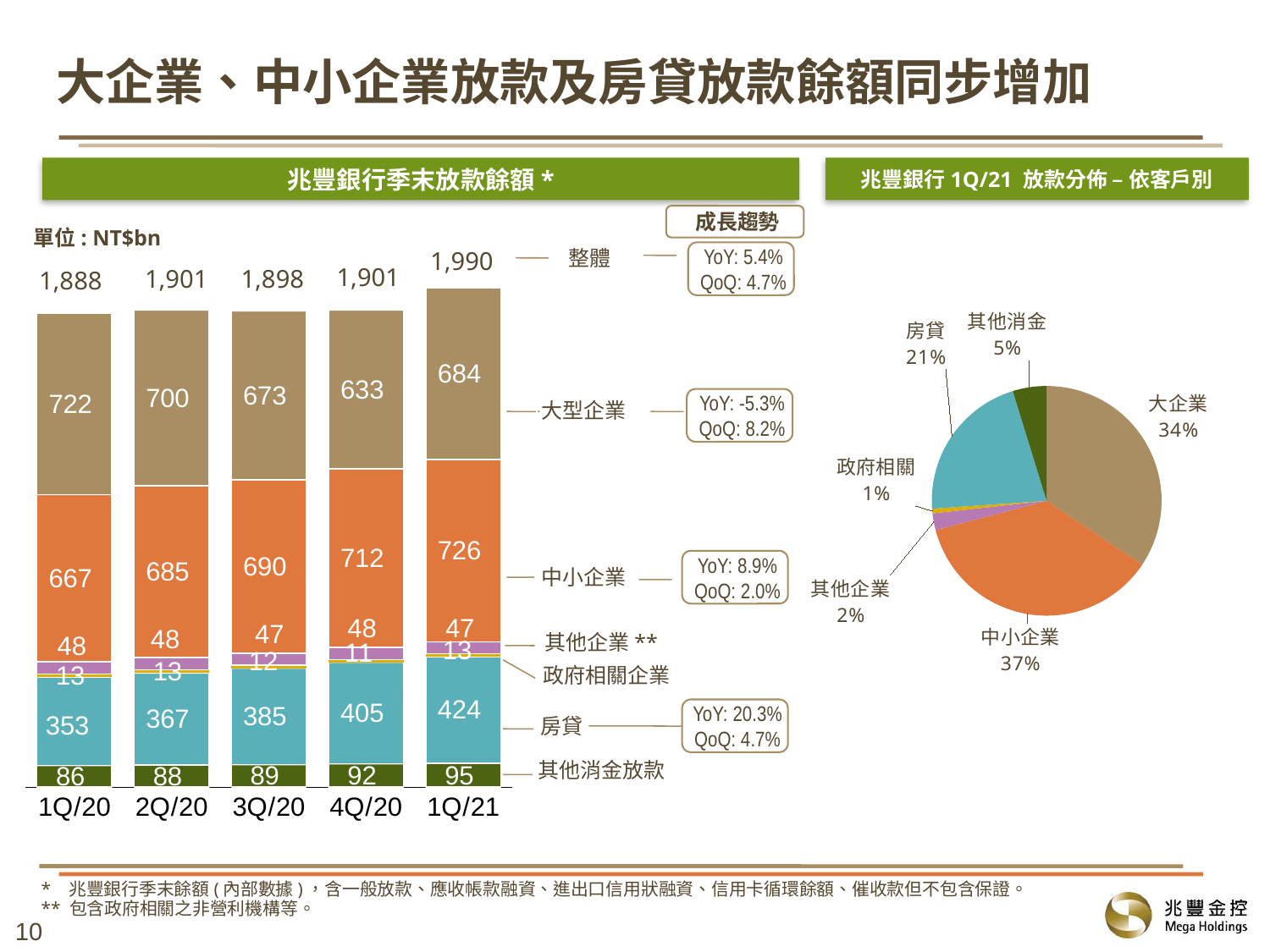
In the 兆豐銀行季末放款餘額 bar chart, by how much did the 中小企業 value increase from 1Q/20 to 1Q/21? 59 How many quarters are shown in the 兆豐銀行季末放款餘額 bar chart? 5 In the 兆豐銀行季末放款餘額 bar chart, which quarter has the lowest 大型企業 value? 4Q/20 In the 兆豐銀行 1Q/21 放款分佈 pie chart, what share does 中小企業 have? 37% In the 兆豐銀行季末放款餘額 bar chart, does the 房貸 value rise or fall from 1Q/20 to 1Q/21? Rise In the 兆豐銀行季末放款餘額 bar chart, what is the total loan balance for 1Q/21? 1,990 In the 兆豐銀行季末放款餘額 bar chart, what is the 大型企業 value for 4Q/20? 633 In the 兆豐銀行季末放款餘額 bar chart, what is the 房貸 value for 1Q/21? 424 What kind of chart is the 兆豐銀行季末放款餘額 chart on the left? Stacked bar chart In the 兆豐銀行季末放款餘額 bar chart, which is larger in 1Q/21: 大型企業 or 中小企業? 中小企業 In the 兆豐銀行季末放款餘額 bar chart, which quarter has the highest total loan balance? 1Q/21 In the 兆豐銀行 1Q/21 放款分佈 pie chart, which category has the smallest share? 政府相關